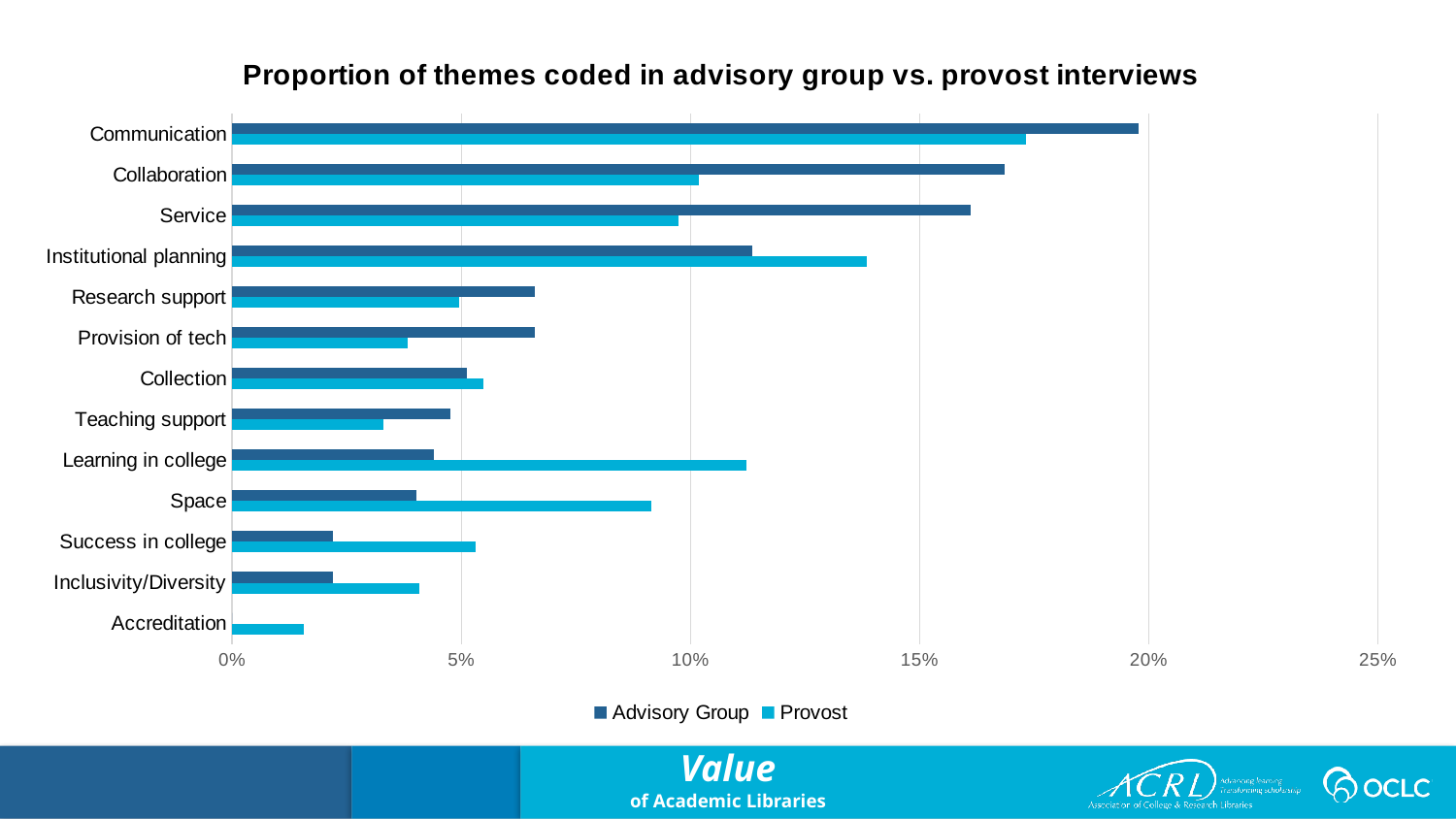
Which theme has the highest Advisory Group value? Communication What is the title of the chart? Proportion of themes coded in advisory group vs. provost interviews Is the Advisory Group value for Communication greater or less than 15%? greater For Learning in college, which series has the larger value, Advisory Group or Provost? Provost How many theme categories are plotted on the chart? 13 How many series does the legend list? 2 Is the Provost value for Space greater or less than 10%? less For Service, which series has the larger value, Advisory Group or Provost? Advisory Group For Institutional planning, which series has the larger value, Advisory Group or Provost? Provost What kind of chart is shown on the slide? Bar chart Which theme has the lowest Provost value? Accreditation Which theme has the highest Provost value? Communication